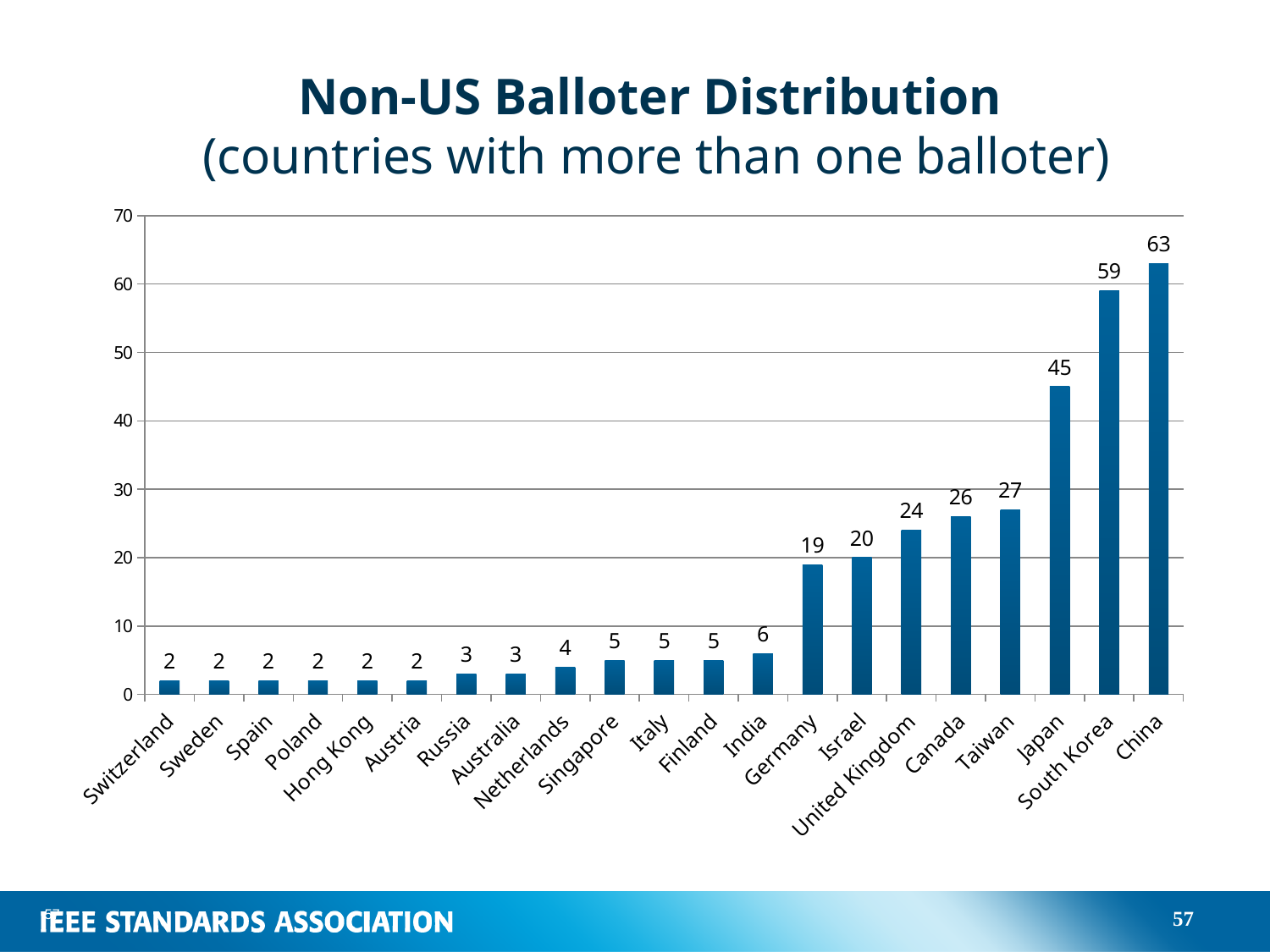
How many countries are shown on the chart? 21 Which has a larger value, India or Netherlands? India What is the value shown for Germany? 19 Do the values rise or fall moving from left to right along the x axis? Rise What is the difference between the values for Japan and Taiwan? 18 What is the difference between the values for China and South Korea? 4 Which has a larger value, Canada or Israel? Canada What is the value shown for the United Kingdom? 24 What is the title of the chart? Non-US Balloter Distribution (countries with more than one balloter) How many balloters does China have? 63 Which country has the highest number of balloters? China What kind of chart is shown on the slide? Bar chart